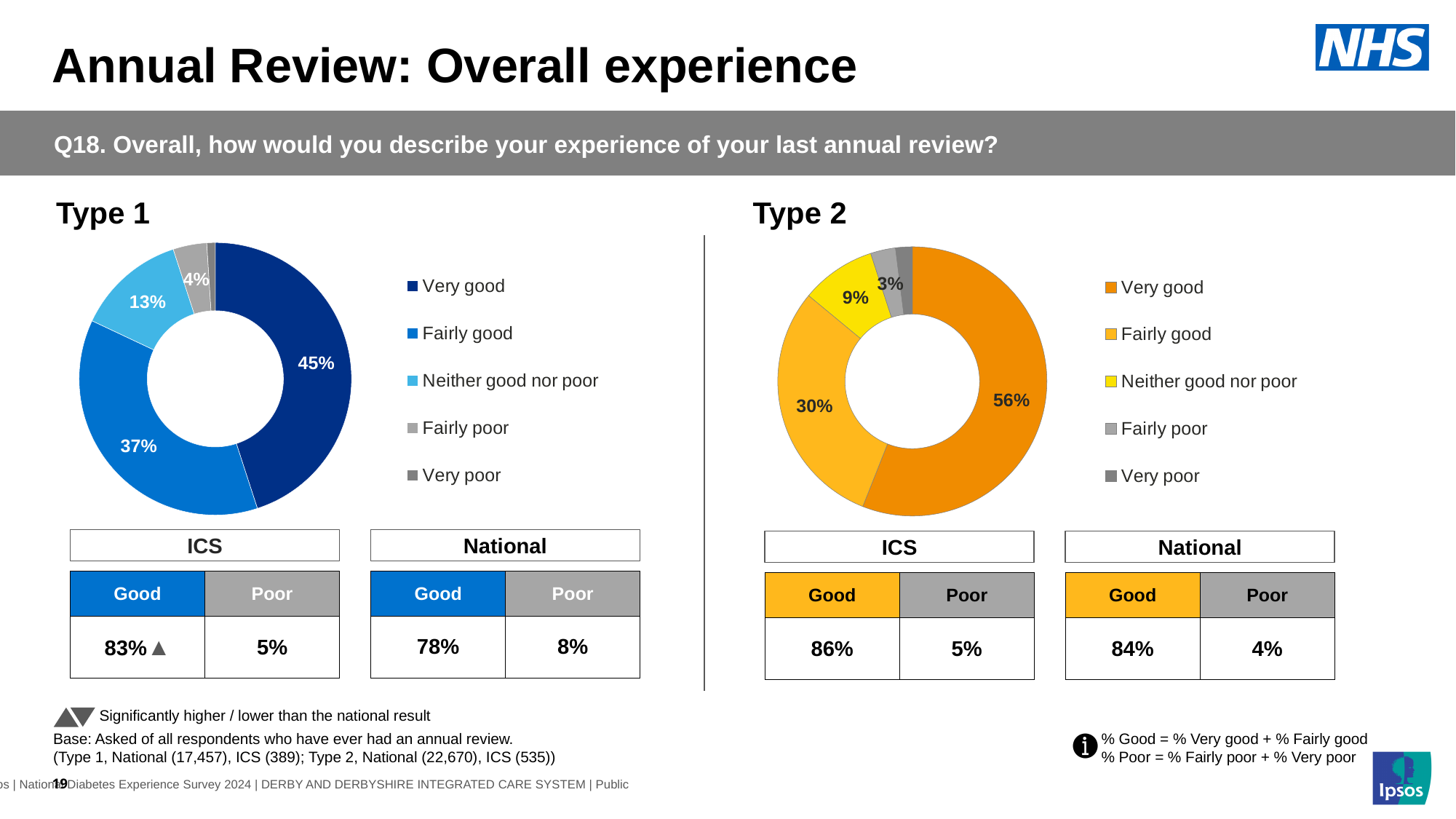
In the Type 2 chart, what percentage of respondents said their experience was 'Fairly good'? 30% How many categories does the legend of the Type 2 chart list? 5 In the Type 1 chart, what percentage of respondents said their experience was 'Very good'? 45% Which chart shows a larger 'Very good' share, Type 1 or Type 2? Type 2 What colour represents 'Neither good nor poor' in the Type 2 chart? Yellow What kind of chart is used for Type 1? Donut (pie) chart In the Type 2 chart, what is the combined share of 'Very good' and 'Fairly good'? 86% In the Type 1 chart, what percentage said 'Neither good nor poor'? 13% In the Type 1 chart, what is the difference between the 'Very good' and 'Fairly good' shares? 8% In the Type 1 chart, which labelled category has the smallest share? Fairly poor In the Type 2 chart, what percentage said 'Fairly poor'? 3% In the Type 2 chart, which category has the largest share? Very good